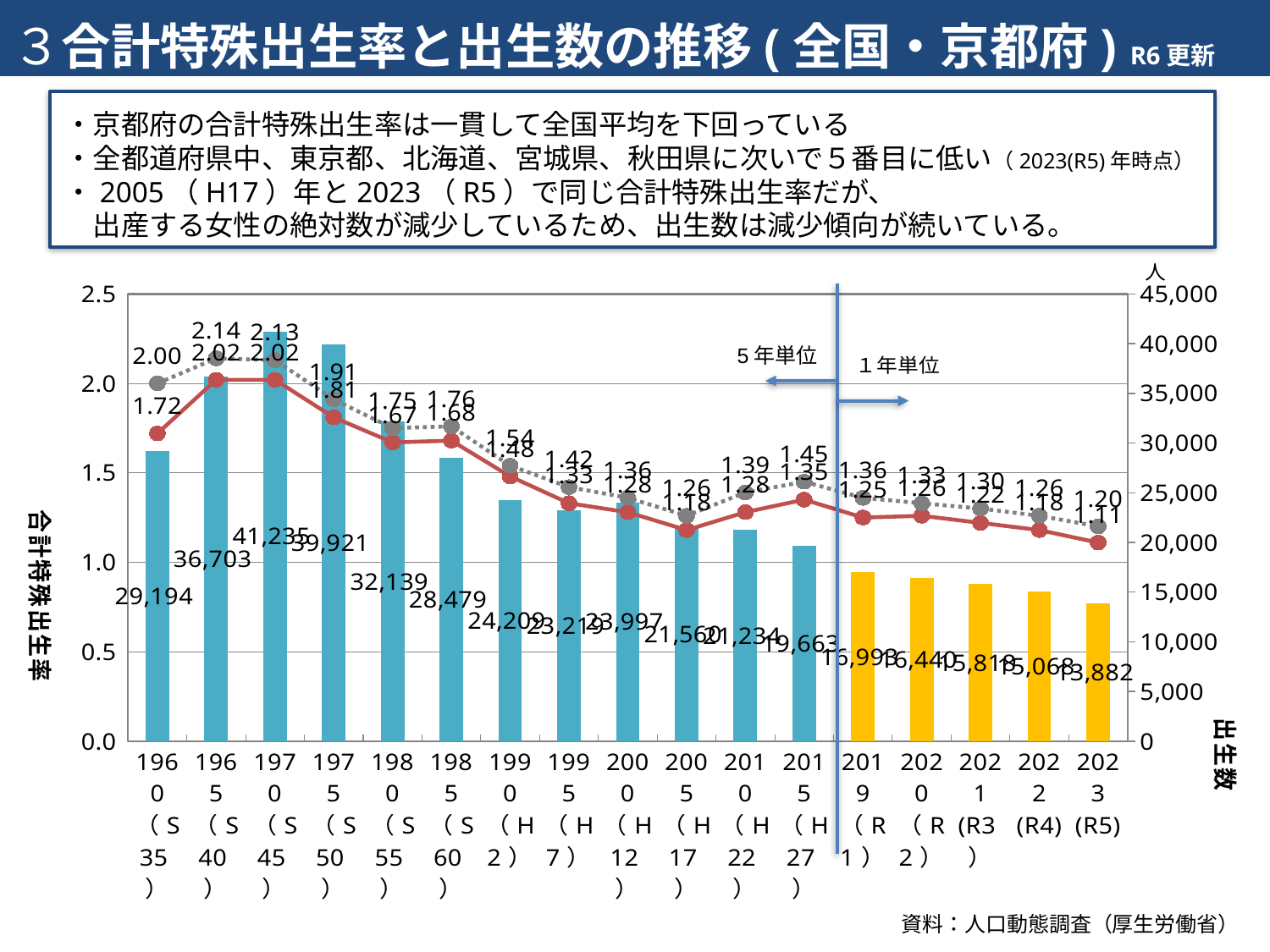
How many year categories are shown along the x axis? 17 What is the value of the gray dotted line (全国 total fertility rate) in 1965 (S40)? 2.14 What kind of chart is shown on the slide? Combined bar and line chart Which year has the lowest number of births (出生数)? 2023 (R5) What is the label of the right-hand vertical axis? 出生数 What is the number of births (出生数) shown for 1970 (S45)? 41,235 Which year has more births, 1995 (H7) or 2000 (H12)? 2000 (H12) Which year has the highest number of births (出生数)? 1970 (S45) What is the value of the red line (京都府 total fertility rate) in 2023 (R5)? 1.11 What is the difference in the number of births between 2022 (R4) and 2023 (R5)? 1,186 Do the number of births rise or fall from 2019 (R1) to 2023 (R5)? Fall In 1960 (S35), what is the difference between the gray dotted line value (2.00) and the red line value (1.72)? 0.28